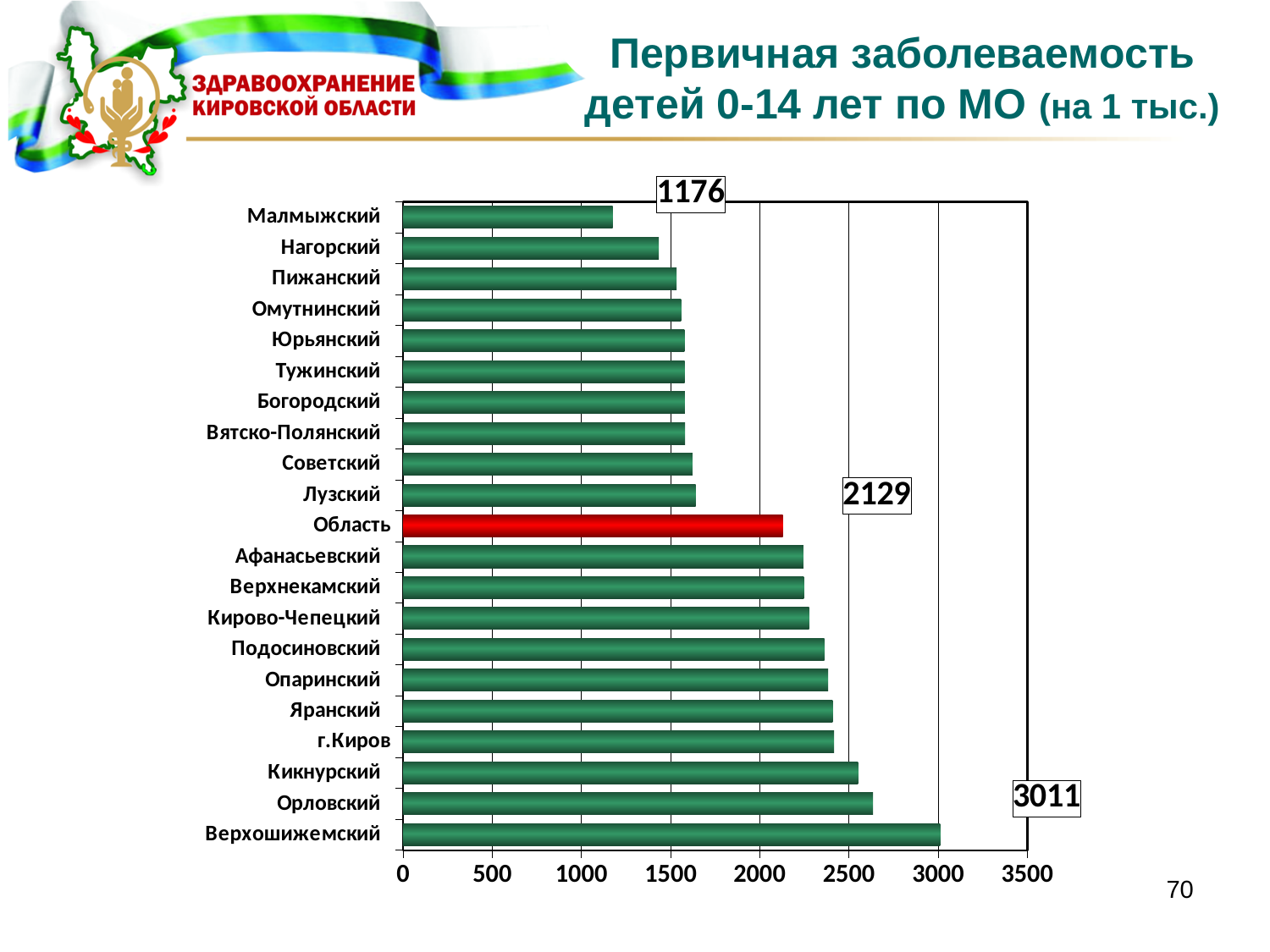
What is the value for Малмыжский? 1176 Is the value for Нагорский greater or less than 1500? less What kind of chart is shown on the slide? bar chart How many categories are shown on the chart? 21 What is the difference between the values for Область and Малмыжский? 953 Is the value for Кикнурский greater or less than 2500? greater What is the difference between the values for Верхошижемский and Малмыжский? 1835 What is the value for Верхошижемский? 3011 Which is larger, the value for Орловский or the value for Нагорский? Орловский Which category has the highest value? Верхошижемский Which category has the lowest value? Малмыжский What is the value for Область? 2129